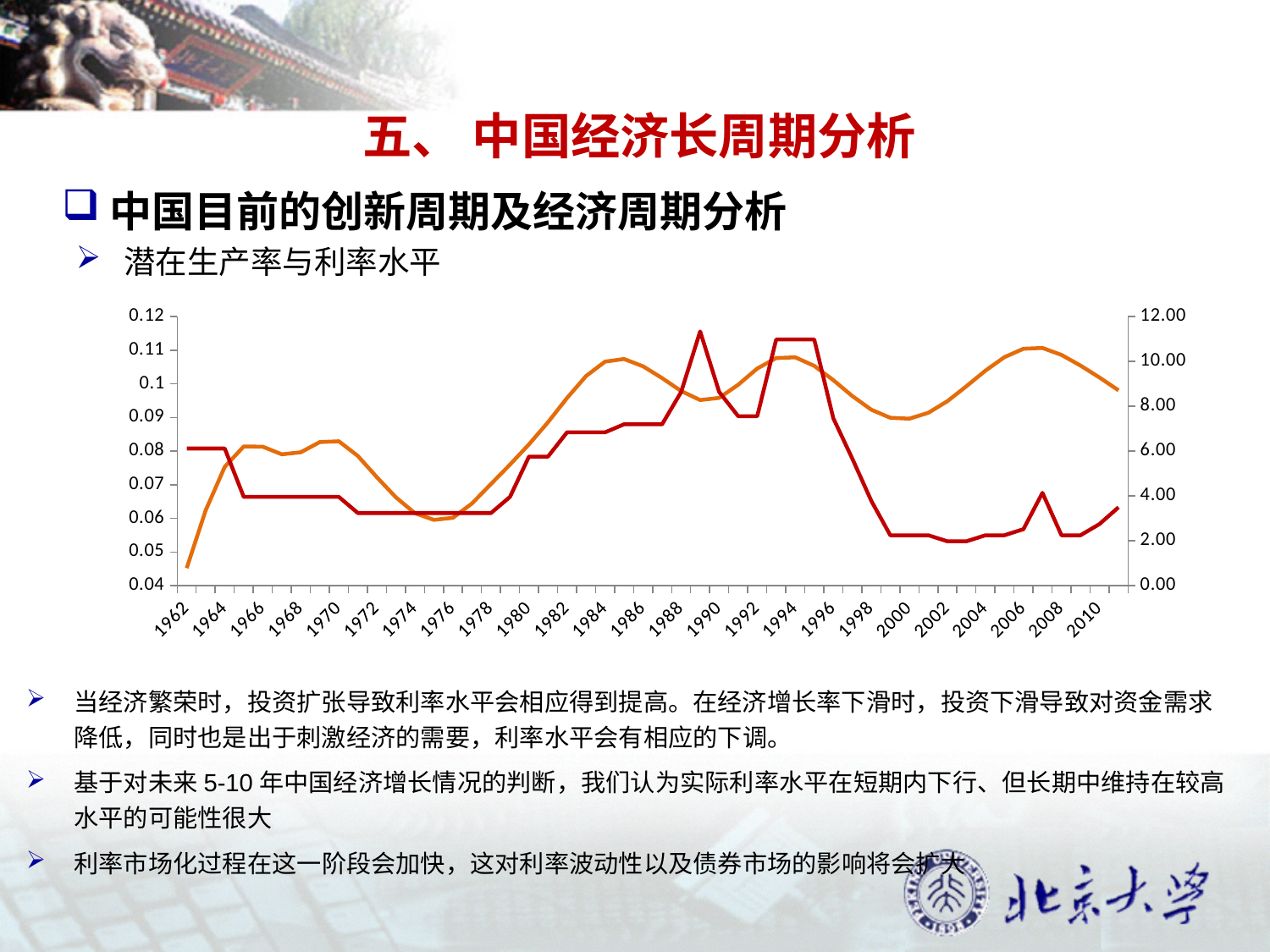
Is the dark red line higher at 1989 or at 2000? 1989 How many year labels are shown along the x axis of the chart? 25 What is the highest value shown on the right-hand axis of the chart? 12.00 What kind of chart is shown on the slide? line chart What is the first year labelled on the x axis of the chart? 1962 Read against the right-hand axis, is the value of the dark red line at 2000 greater or less than 4.00? less Read against the right-hand axis, is the value of the dark red line at 1989 greater or less than 10.00? greater Does the orange line rise or fall between 1976 and 1985? rise In which year does the orange line reach its lowest point? 1962 Read against the left-hand axis, is the value of the orange line at 1962 greater or less than 0.05? less Does the dark red line rise or fall between 1996 and 2000? fall